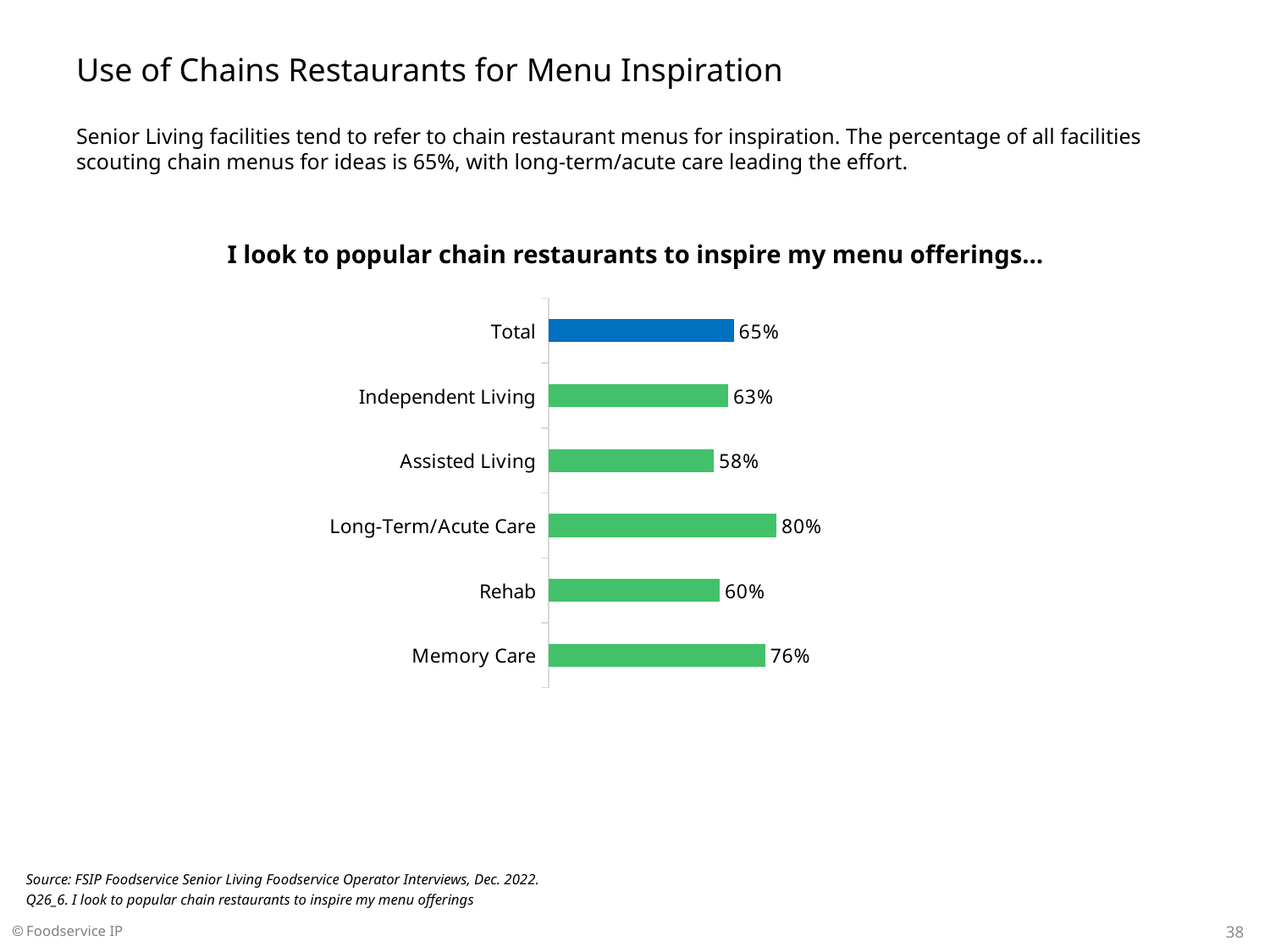
What is the value for Long-Term/Acute Care? 80% What kind of chart is shown on the slide? Bar chart What is the value for Assisted Living? 58% What is the value for Total? 65% What is the difference between the values for Memory Care and Independent Living? 13% What is the value for Memory Care? 76% What is the title of the chart? I look to popular chain restaurants to inspire my menu offerings… How many categories are shown in the chart? 6 Which category has the highest value? Long-Term/Acute Care What is the difference between the values for Long-Term/Acute Care and Rehab? 20% Which is larger, the value for Rehab or the value for Independent Living? Independent Living Which category has the lowest value? Assisted Living